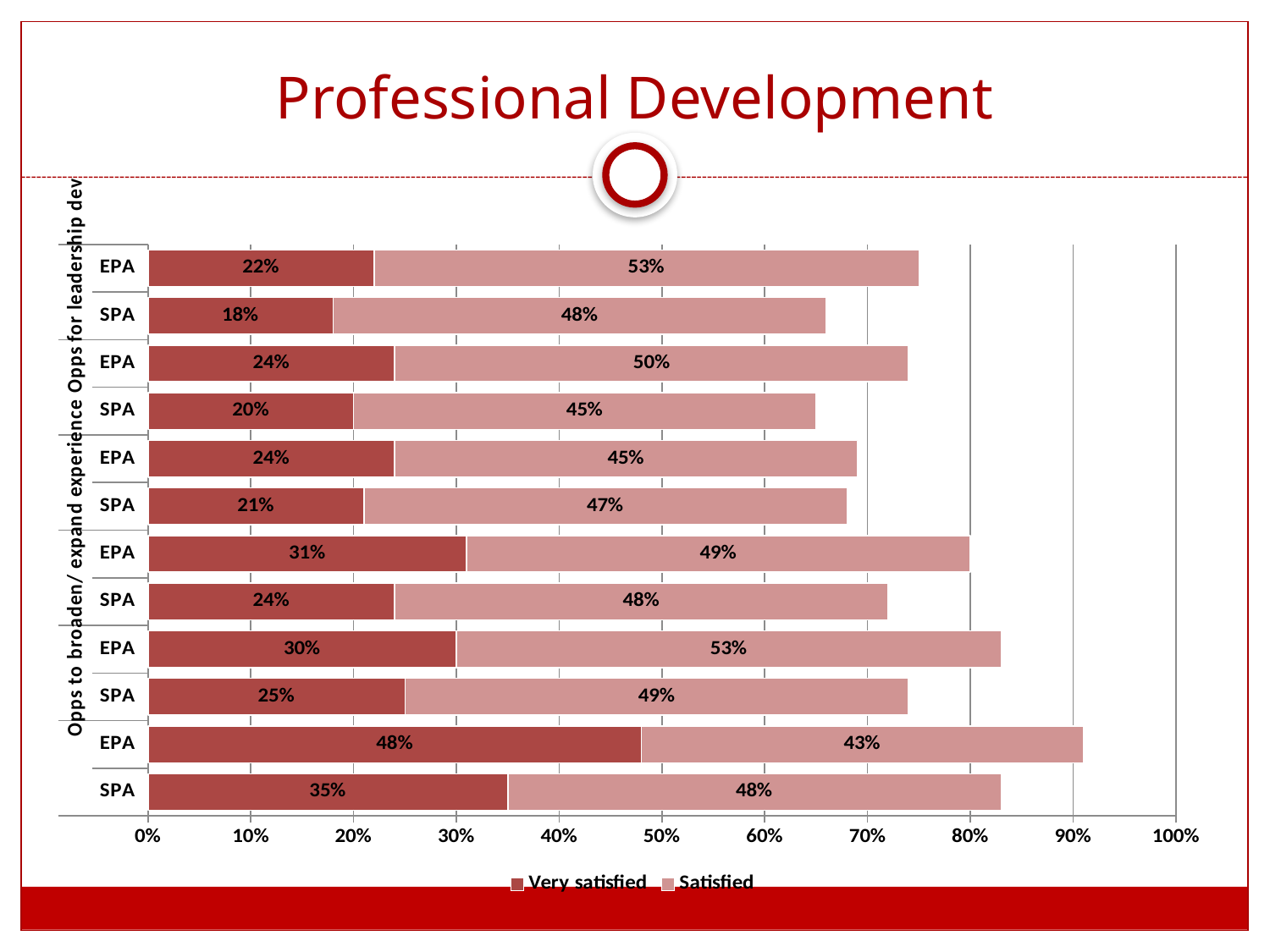
What are the two legend entries of the chart? Very satisfied and Satisfied What is the Satisfied value for the bottommost bar (SPA)? 48% How many series does the legend list? 2 What kind of chart is shown on the slide? Stacked bar chart Which bar has the highest Very satisfied value, and what is it? The second bar from the bottom (EPA), 48% How many bars are plotted in the chart? 12 What is the combined total (Very satisfied plus Satisfied) of the second bar from the bottom (EPA)? 91% Which is larger: the Satisfied value of the topmost bar (EPA) or the Satisfied value of the second bar from the top (SPA)? The topmost bar (EPA), 53% What is the Very satisfied value for the topmost bar (EPA)? 22% What is the difference between the Very satisfied values of the second bar from the bottom (EPA, 48%) and the bottommost bar (SPA, 35%)? 13% What is the lowest Very satisfied value shown in the chart? 18% What is the combined total (Very satisfied plus Satisfied) of the topmost bar (EPA)? 75%